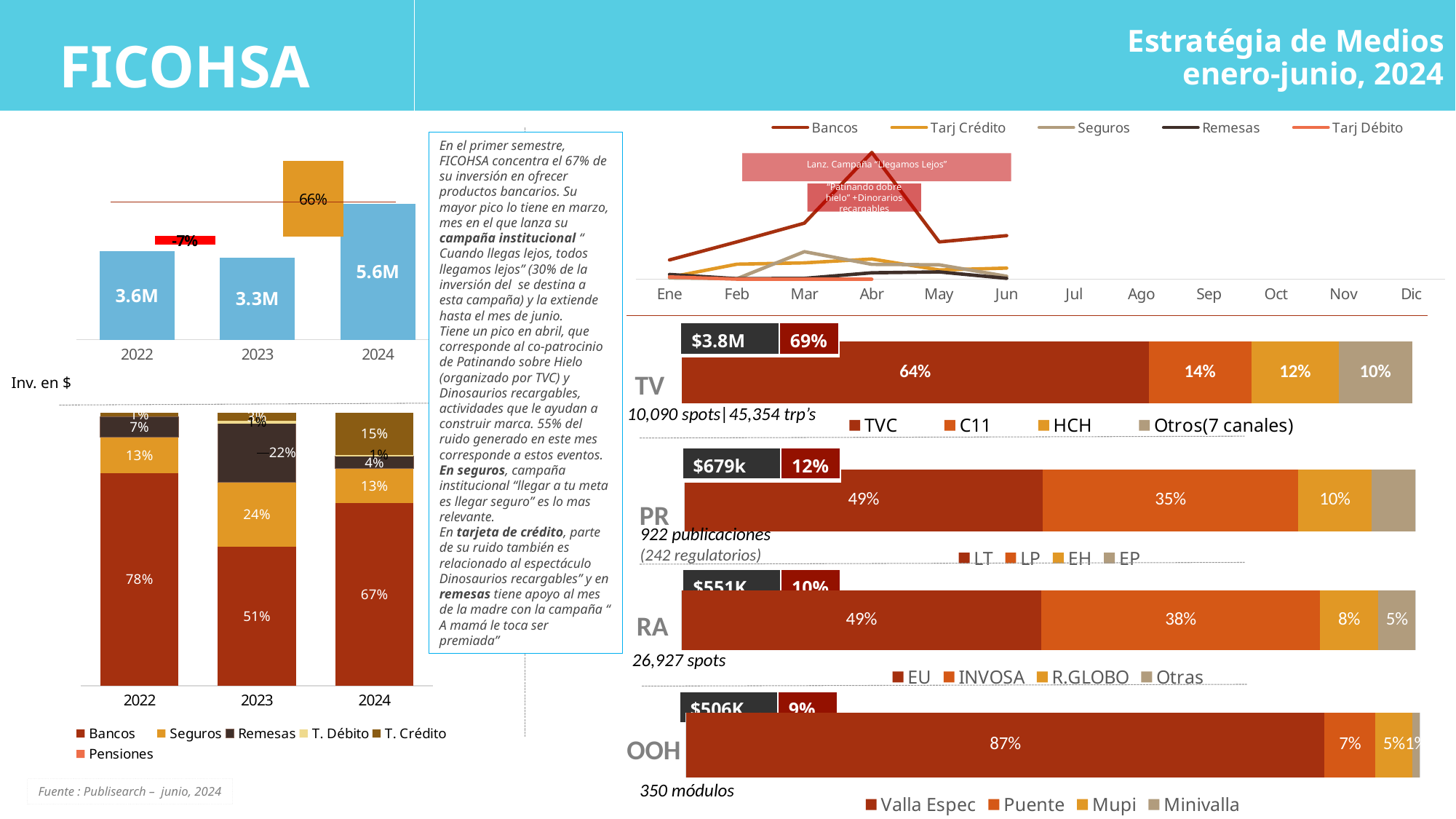
In the 'Inv. en $' bar chart on the left, what is the value for 2024? 5.6M In the stacked bar chart at the bottom left, what share does Bancos have in 2023? 51% In the stacked bar chart at the bottom left, how many entries does the legend list? 6 In the stacked bar chart at the bottom left, what share does Seguros have in 2023? 24% In the OOH bar on the right, what share does Valla Espec have? 87% In the RA bar on the right, which is larger, EU or INVOSA? EU In the TV bar on the right, what share does TVC have? 64% In the 'Inv. en $' bar chart on the left, which year has the lowest investment? 2023 In the line chart at the top right, in which month does the Bancos line reach its peak? Abr In the line chart at the top right, how many series does the legend list? 5 In the 'Inv. en $' bar chart on the left, what percentage change is shown between 2023 and 2024? 66% In the TV bar on the right, what is the difference between the C11 share and the HCH share? 2%